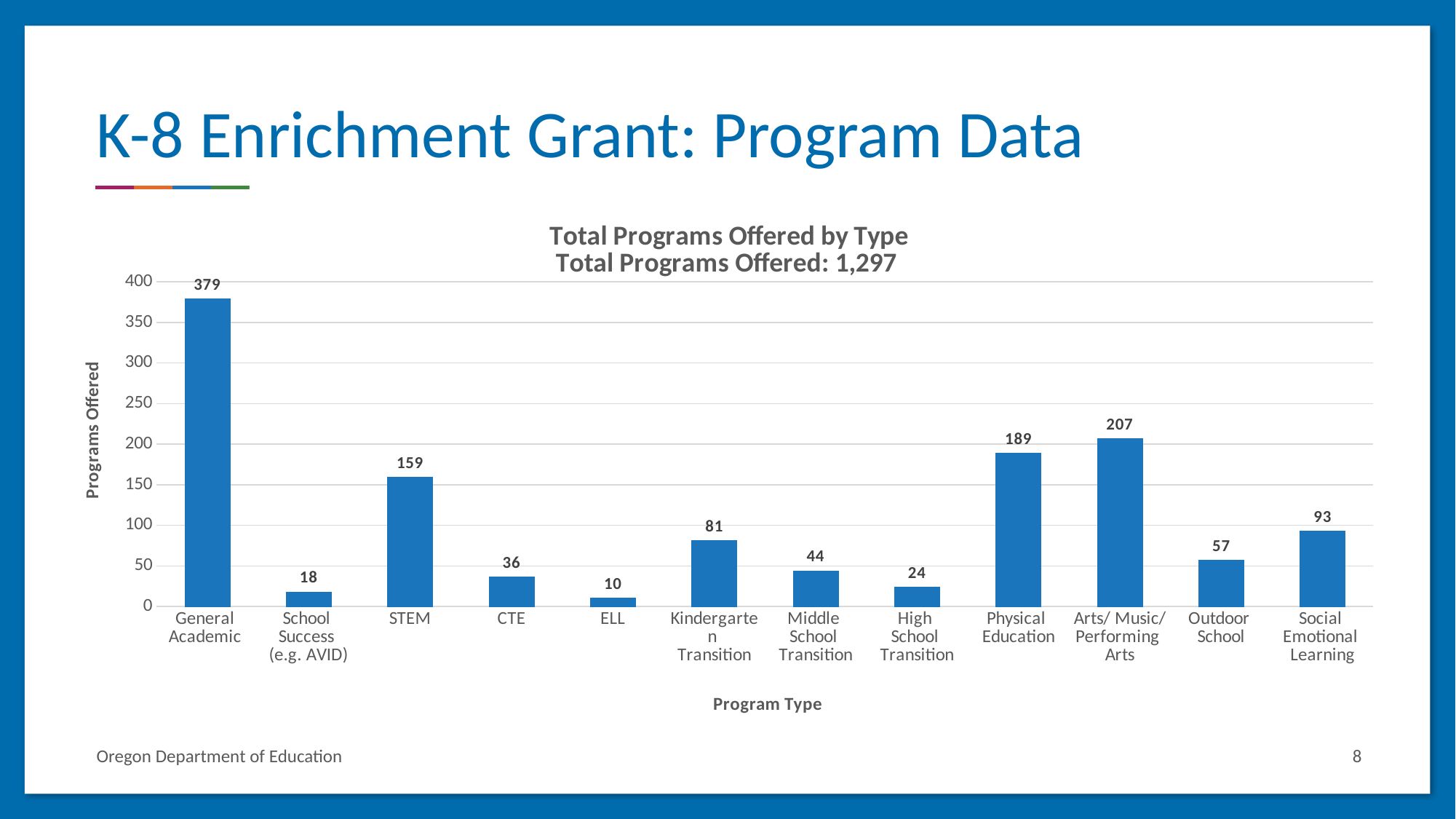
How many program types are shown on the x axis? 12 What is the difference between the values for Arts/ Music/ Performing Arts and Physical Education? 18 What is the difference between the values for STEM and Social Emotional Learning? 66 Which program type has the lowest number of programs offered? ELL What is the value for Arts/ Music/ Performing Arts? 207 What kind of chart is shown on the slide? bar chart Is the value for CTE greater or less than 50? less What total number of programs offered is stated in the chart title? 1,297 Which program type has the highest number of programs offered? General Academic How many programs are offered for General Academic? 379 How many programs are offered for Kindergarten Transition? 81 Which is larger, the value for Outdoor School or the value for Middle School Transition? Outdoor School